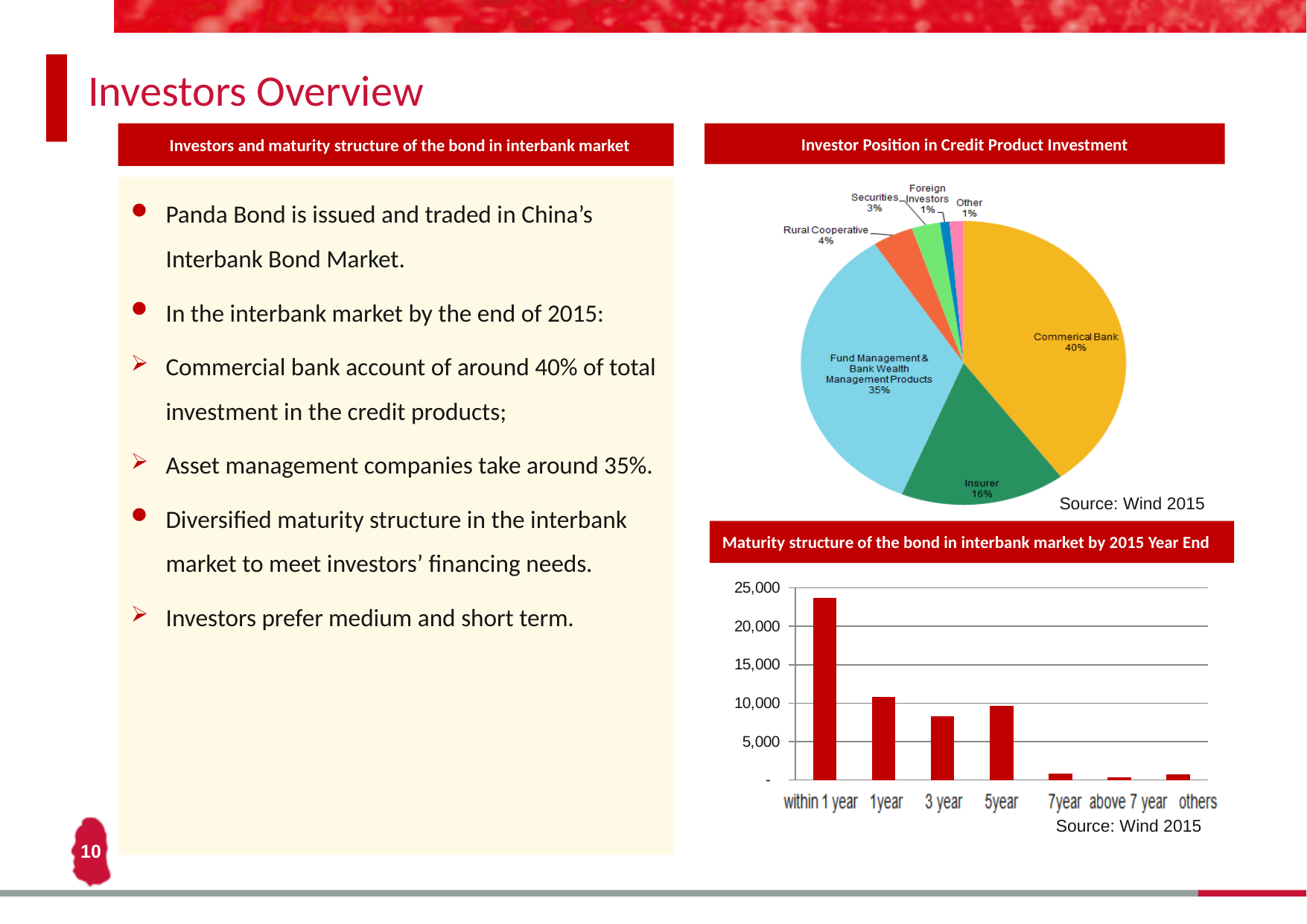
In the pie chart 'Investor Position in Credit Product Investment', which is larger, Securities or Rural Cooperative? Rural Cooperative In the bar chart 'Maturity structure of the bond in interbank market by 2015 Year End', is the value for '3 year' greater or less than 10,000? less In the bar chart 'Maturity structure of the bond in interbank market by 2015 Year End', is the value for 'within 1 year' greater or less than 20,000? greater In the pie chart 'Investor Position in Credit Product Investment', which category has the largest share? Commerical Bank In the pie chart 'Investor Position in Credit Product Investment', what share does Commercial Bank hold? 40% In the pie chart 'Investor Position in Credit Product Investment', what share does Rural Cooperative hold? 4% What type of chart is 'Maturity structure of the bond in interbank market by 2015 Year End'? Bar chart In the bar chart 'Maturity structure of the bond in interbank market by 2015 Year End', which category has the highest value? within 1 year How many categories are shown on the x axis of the bar chart 'Maturity structure of the bond in interbank market by 2015 Year End'? 7 In the pie chart 'Investor Position in Credit Product Investment', what is the difference in percentage points between Commercial Bank and Fund Management & Bank Wealth Management Products? 5 percentage points How many slices does the pie chart 'Investor Position in Credit Product Investment' have? 7 In the pie chart 'Investor Position in Credit Product Investment', what share does Insurer hold? 16%